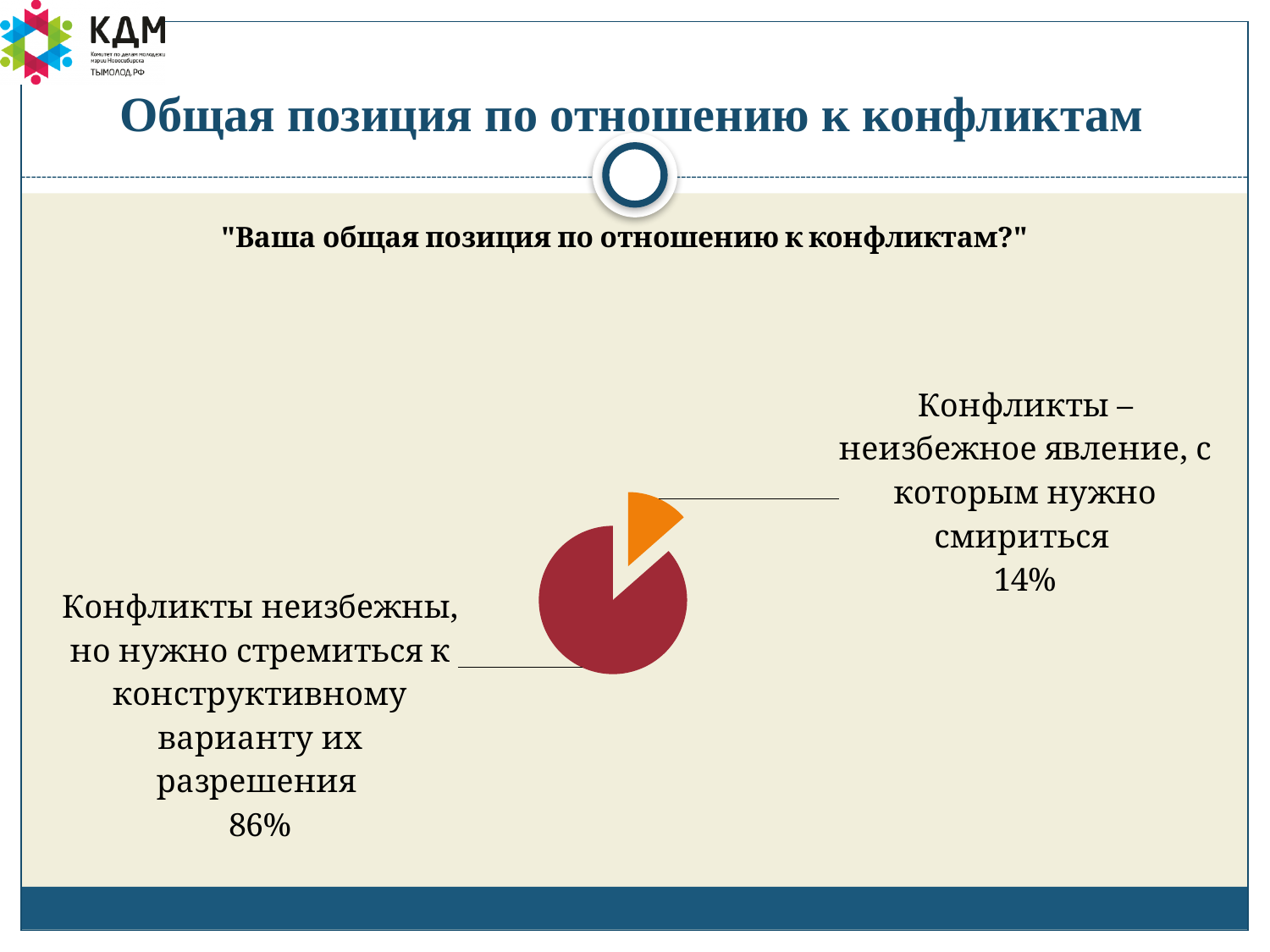
Which slice of the pie is the largest? Конфликты неизбежны, но нужно стремиться к конструктивному варианту их разрешения What share of the pie is labelled "Конфликты – неизбежное явление, с которым нужно смириться"? 14% What is the difference in percentage points between the two slices of the pie? 72 Which slice of the pie is the smallest? Конфликты – неизбежное явление, с которым нужно смириться What is the total of the two slices shown in the pie chart? 100% Which is larger: the share for "Конфликты неизбежны, но нужно стремиться к конструктивному варианту их разрешения" or the share for "Конфликты – неизбежное явление, с которым нужно смириться"? Конфликты неизбежны, но нужно стремиться к конструктивному варианту их разрешения How many slices does the pie chart have? 2 What is the title of the chart? "Ваша общая позиция по отношению к конфликтам?" What share of the pie is labelled "Конфликты неизбежны, но нужно стремиться к конструктивному варианту их разрешения"? 86% What kind of chart is shown on the slide? Pie chart What colour is the slice representing 14%? Orange